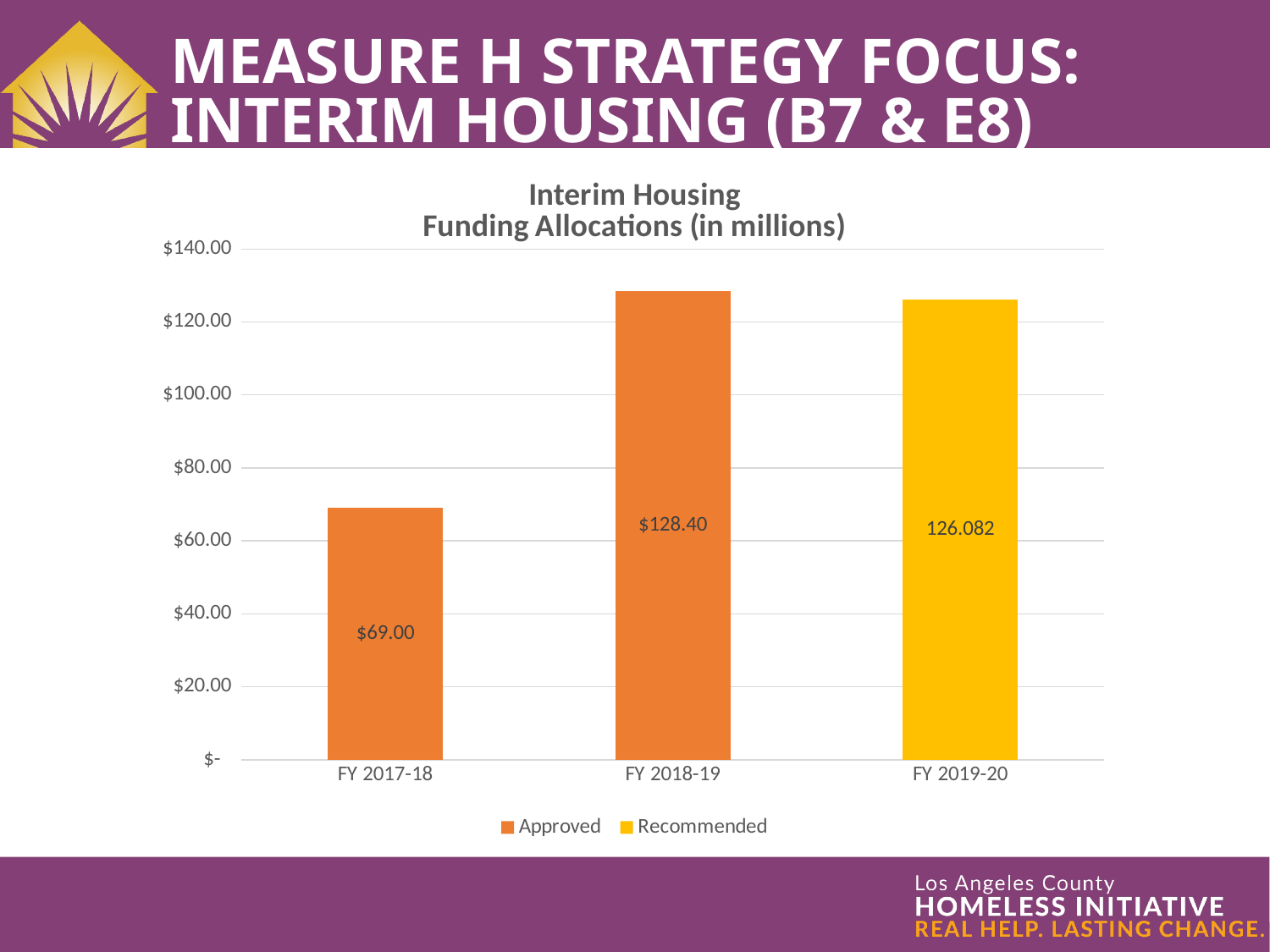
Which series does the FY 2019-20 bar belong to, according to the legend colours? Recommended What type of chart is shown on the slide? bar chart What is the difference between the FY 2018-19 and FY 2017-18 funding allocations? $59.40 Which is larger, the funding allocation for FY 2018-19 or FY 2019-20? FY 2018-19 What is the funding allocation for FY 2017-18? $69.00 How many series does the legend list? 2 Which fiscal year has the highest funding allocation? FY 2018-19 How many fiscal years are shown on the x axis? 3 What is the funding allocation for FY 2018-19? $128.40 Which fiscal year has the lowest funding allocation? FY 2017-18 What is the funding allocation for FY 2019-20? 126.082 Is the value for FY 2017-18 greater or less than $80.00? less